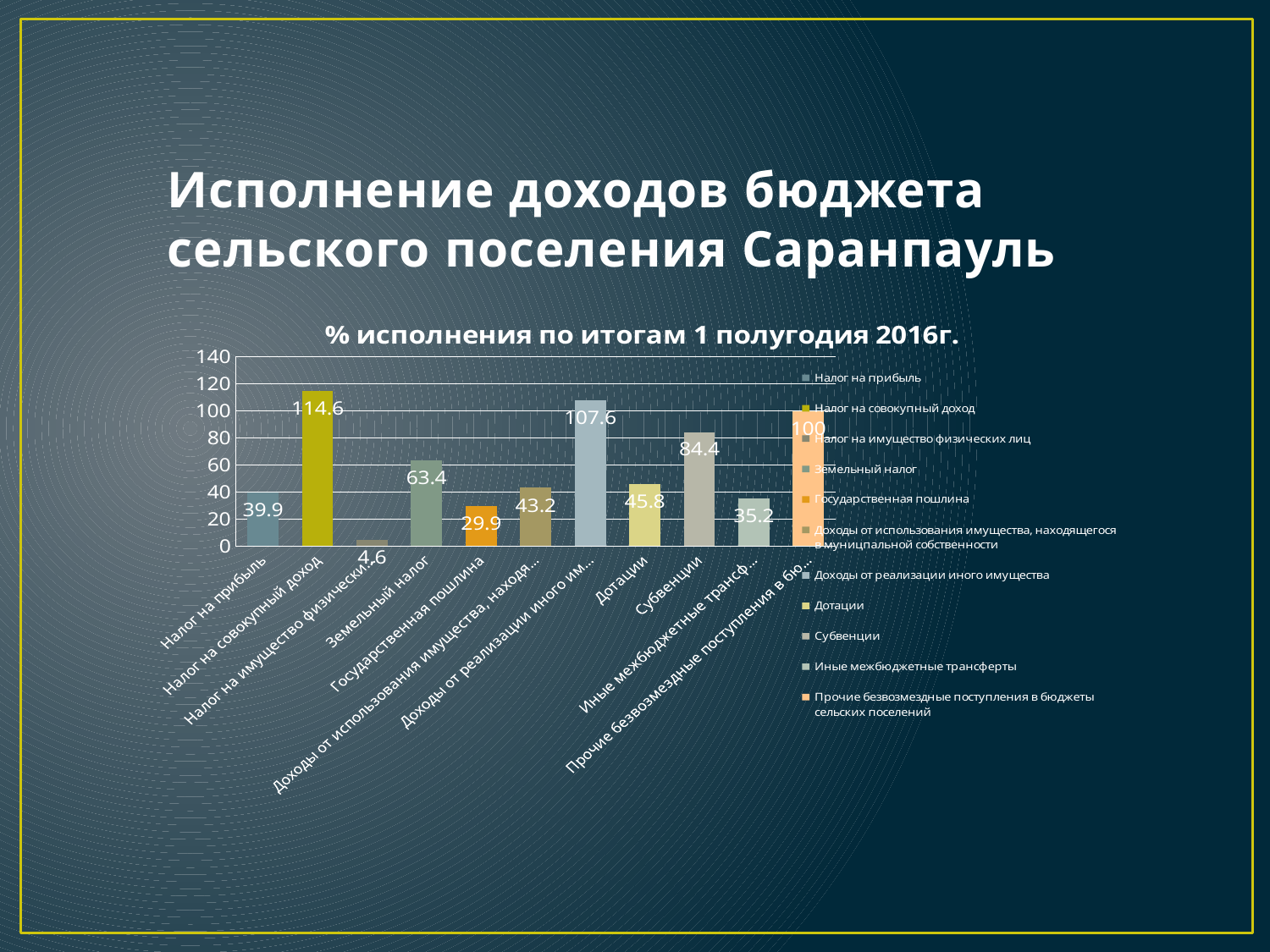
What kind of chart is shown on the slide? bar chart Which is larger, the value for Субвенции or the value for Дотации? Субвенции What is the value for Дотации? 45.8 What is the value for Налог на прибыль? 39.9 Which category has the lowest value? Налог на имущество физических лиц What is the difference between the values for Налог на совокупный доход and Государственная пошлина? 84.7 Is the value for Иные межбюджетные трансферты greater or less than 40? less What is the value for Субвенции? 84.4 How many bars are shown in the chart? 11 What is the value for Земельный налог? 63.4 What is the title of the chart? % исполнения по итогам 1 полугодия 2016г. Which category has the highest value? Налог на совокупный доход